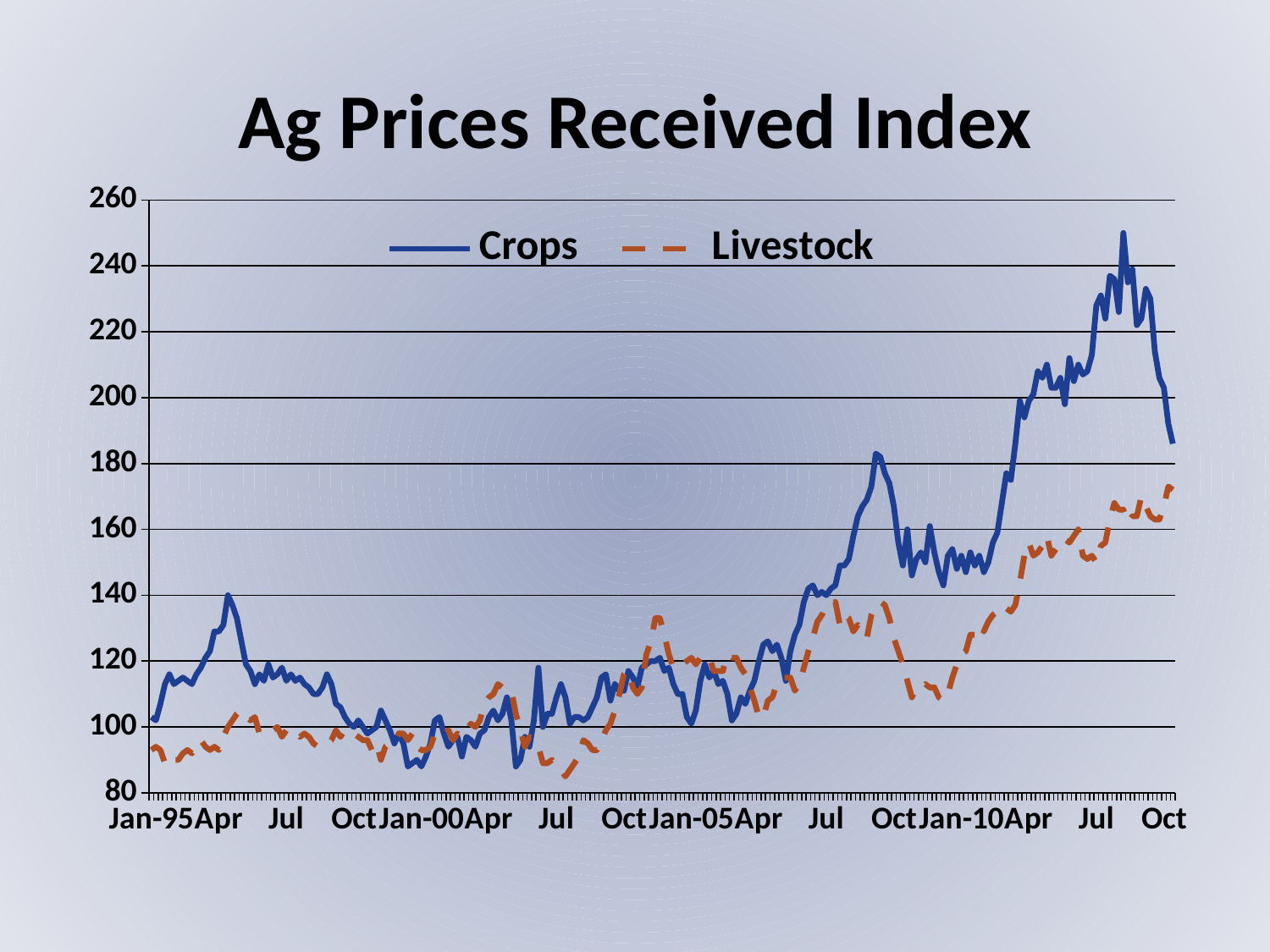
Overall, do the Crops values rise or fall from Jan-95 to the end of the x axis? rise Is the value for Crops at Jan-10 greater or less than 140? greater What kind of chart is shown on the slide? line chart Is the highest value of the Livestock series greater or less than 180? less Is the peak value of the Crops series greater or less than 240? greater At the last point on the x axis (Oct), which series has the higher value, Crops or Livestock? Crops Which series is drawn with a dashed line? Livestock Which series reaches the highest value on the chart? Crops How many series does the legend list? 2 At Jan-10, which series has the higher value, Crops or Livestock? Crops What is the title of the chart? Ag Prices Received Index